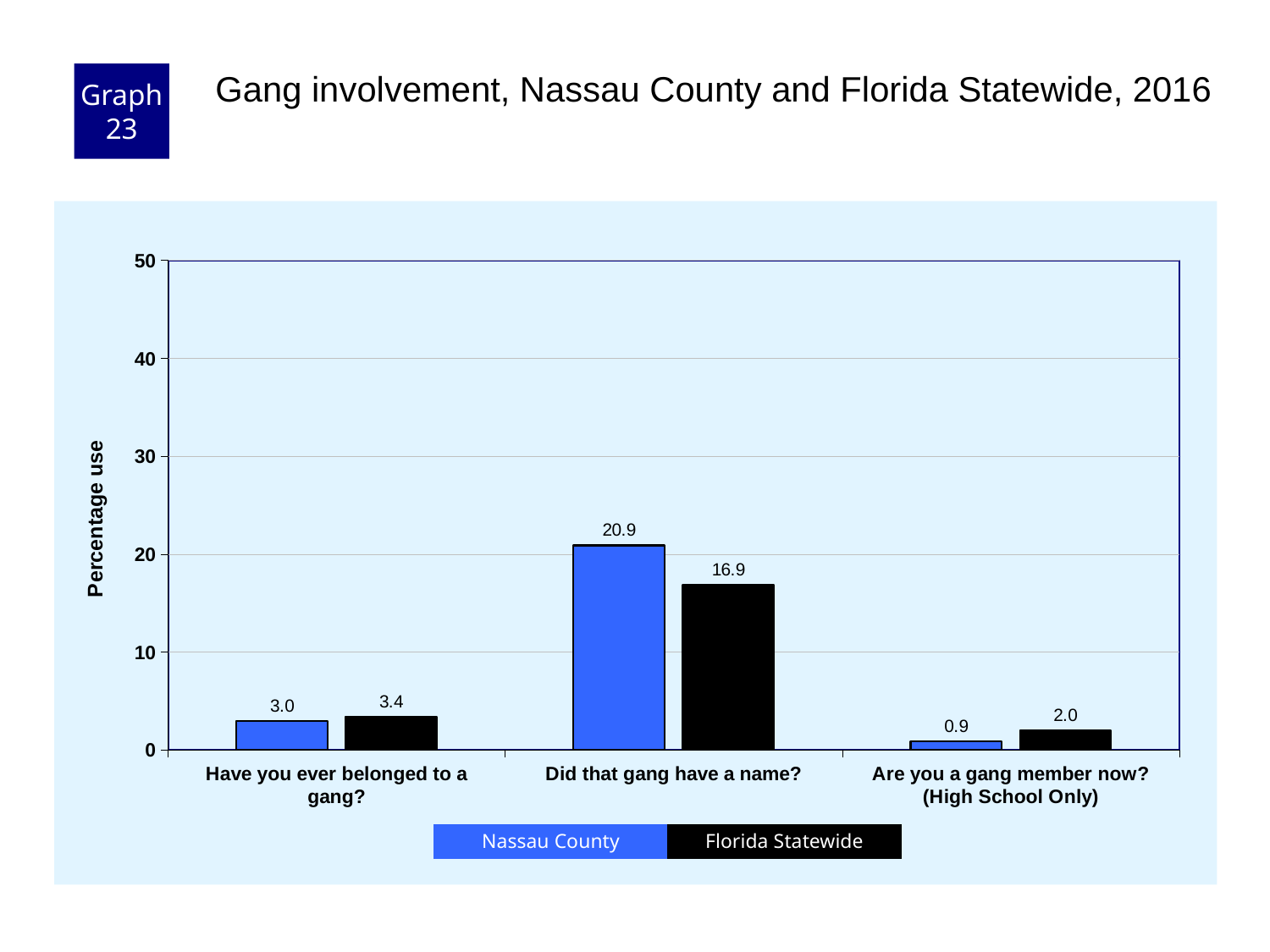
Which question has the highest Nassau County value? Did that gang have a name? What is the label of the y axis? Percentage use How many question categories are shown on the x axis? 3 What is the Nassau County value for "Are you a gang member now? (High School Only)"? 0.9 How many series does the legend list? 2 What is the Florida Statewide value for "Have you ever belonged to a gang?"? 3.4 What is the difference between the Nassau County and Florida Statewide values for "Did that gang have a name?"? 4.0 Is the Nassau County value for "Did that gang have a name?" greater or less than 30? less What is the Nassau County value for "Did that gang have a name?"? 20.9 What kind of chart is shown on the slide? bar chart Which question has the lowest Florida Statewide value? Are you a gang member now? (High School Only) For "Are you a gang member now? (High School Only)", which is larger, Nassau County or Florida Statewide? Florida Statewide